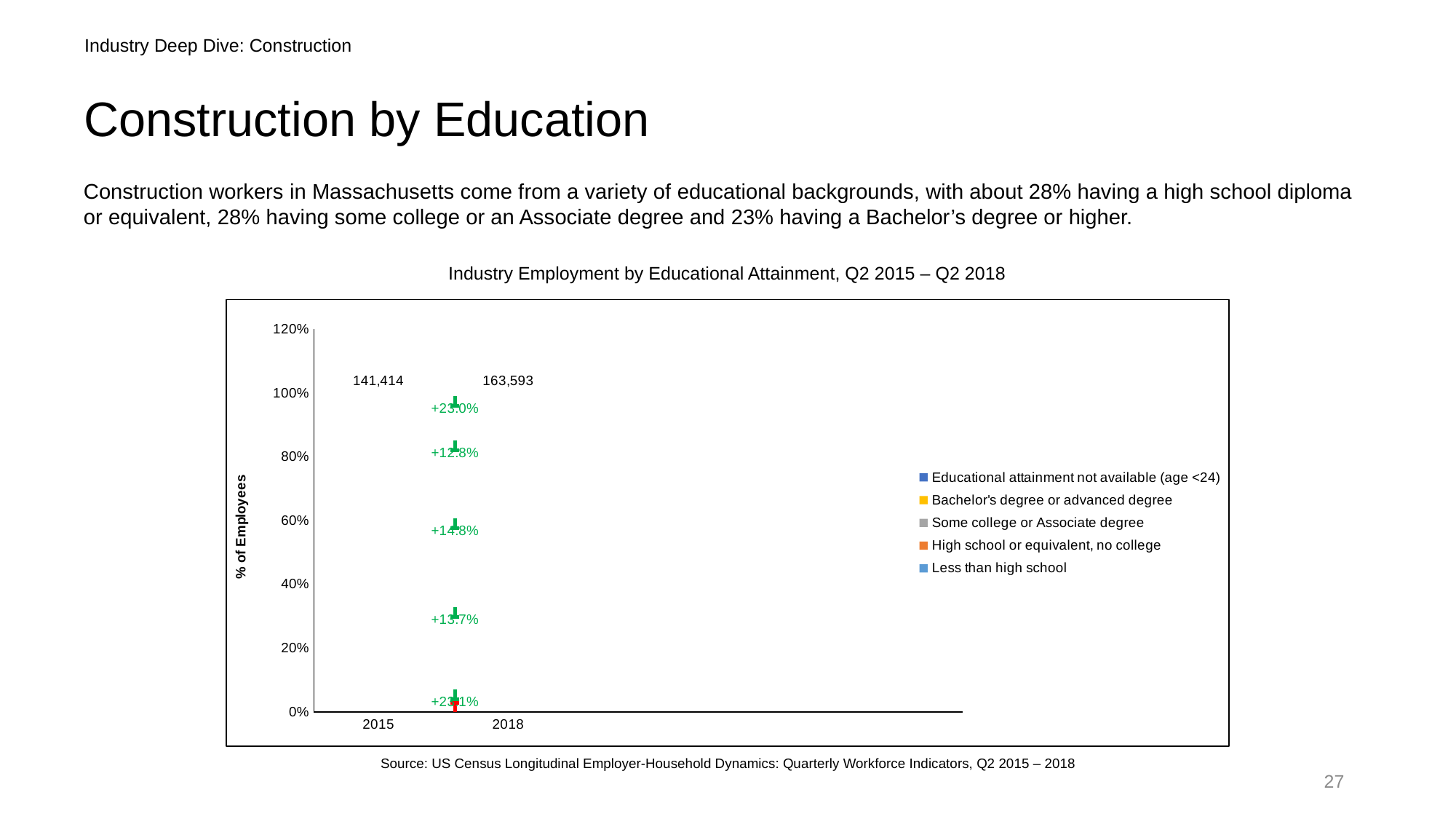
Which year has the larger total employment figure, 2015 or 2018? 2018 What total employment figure is shown above the 2018 category? 163,593 What total employment figure is shown above the 2015 category? 141,414 What is the difference between the 2018 total (163,593) and the 2015 total (141,414)? 22,179 What is the title of the chart? Industry Employment by Educational Attainment, Q2 2015 – Q2 2018 How many series does the legend list? 5 What is the highest value shown on the y axis? 120% How many categories are shown on the x axis? 2 What is the label of the y axis? % of Employees What is the topmost growth label printed between the 2015 and 2018 categories? +23.0% Which years are shown on the x axis? 2015 and 2018